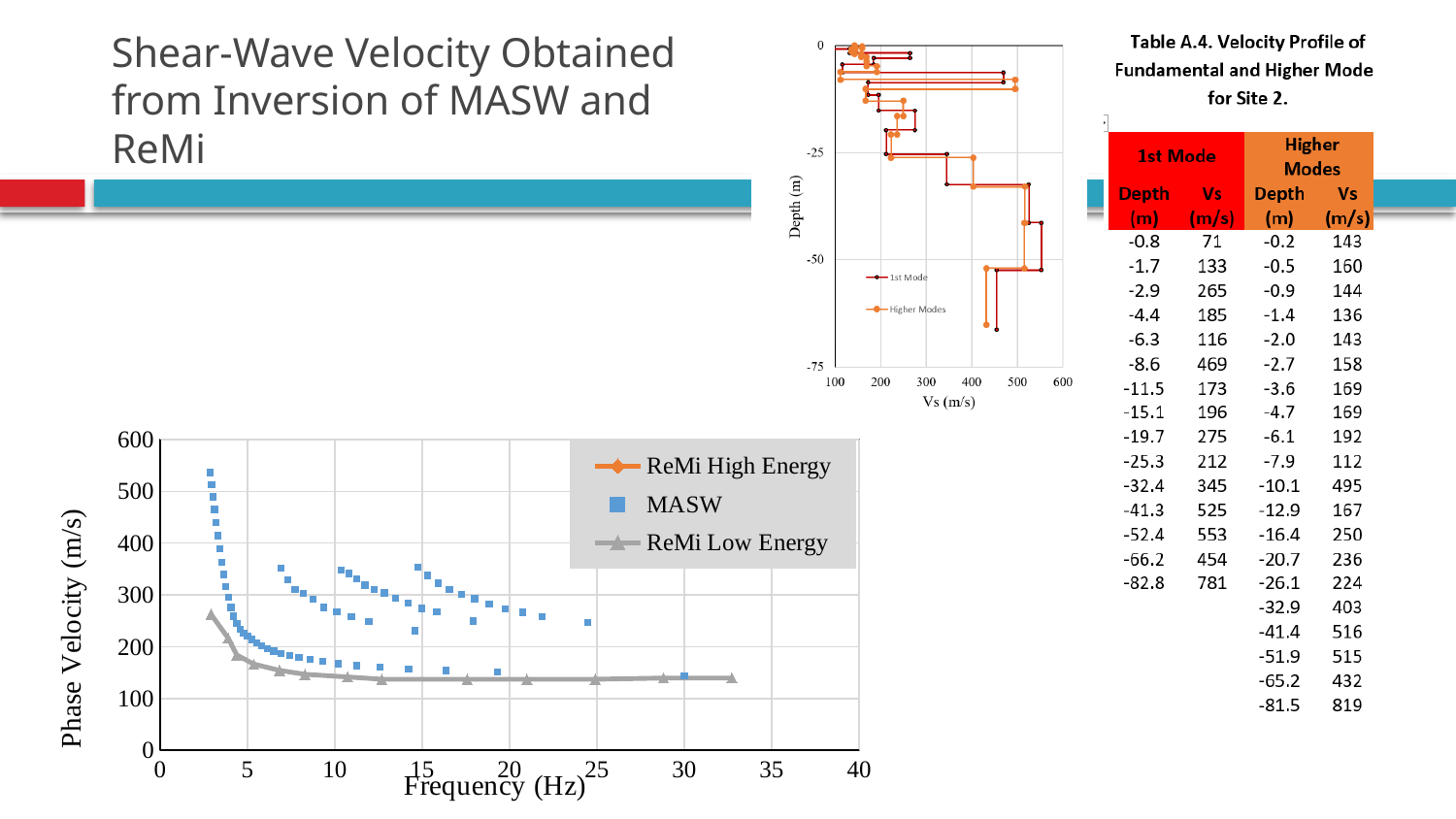
In the bottom-left chart, at about 3 Hz, which series has the higher phase velocity, MASW or ReMi Low Energy? MASW In the bottom-left chart, is the highest MASW phase velocity greater or less than 500? greater In the top-right chart, what is the lowest depth value shown on the vertical axis? -75 In the top-right chart (Depth vs Vs), how many series does the legend list? 2 In the bottom-left chart, what is the label of the vertical axis? Phase Velocity (m/s) In the bottom-left chart, is the ReMi Low Energy phase velocity at 30 Hz greater or less than 200? less In the bottom-left chart, what is the maximum value shown on the Frequency (Hz) axis? 40 In the top-right chart, what are the two legend entries? 1st Mode and Higher Modes In the top-right chart, is the Higher Modes Vs at a depth of -25 m greater or less than 300? less In the bottom-left chart, does the ReMi Low Energy phase velocity rise or fall as frequency increases? fall In the bottom-left chart (Phase Velocity vs Frequency), how many series does the legend list? 3